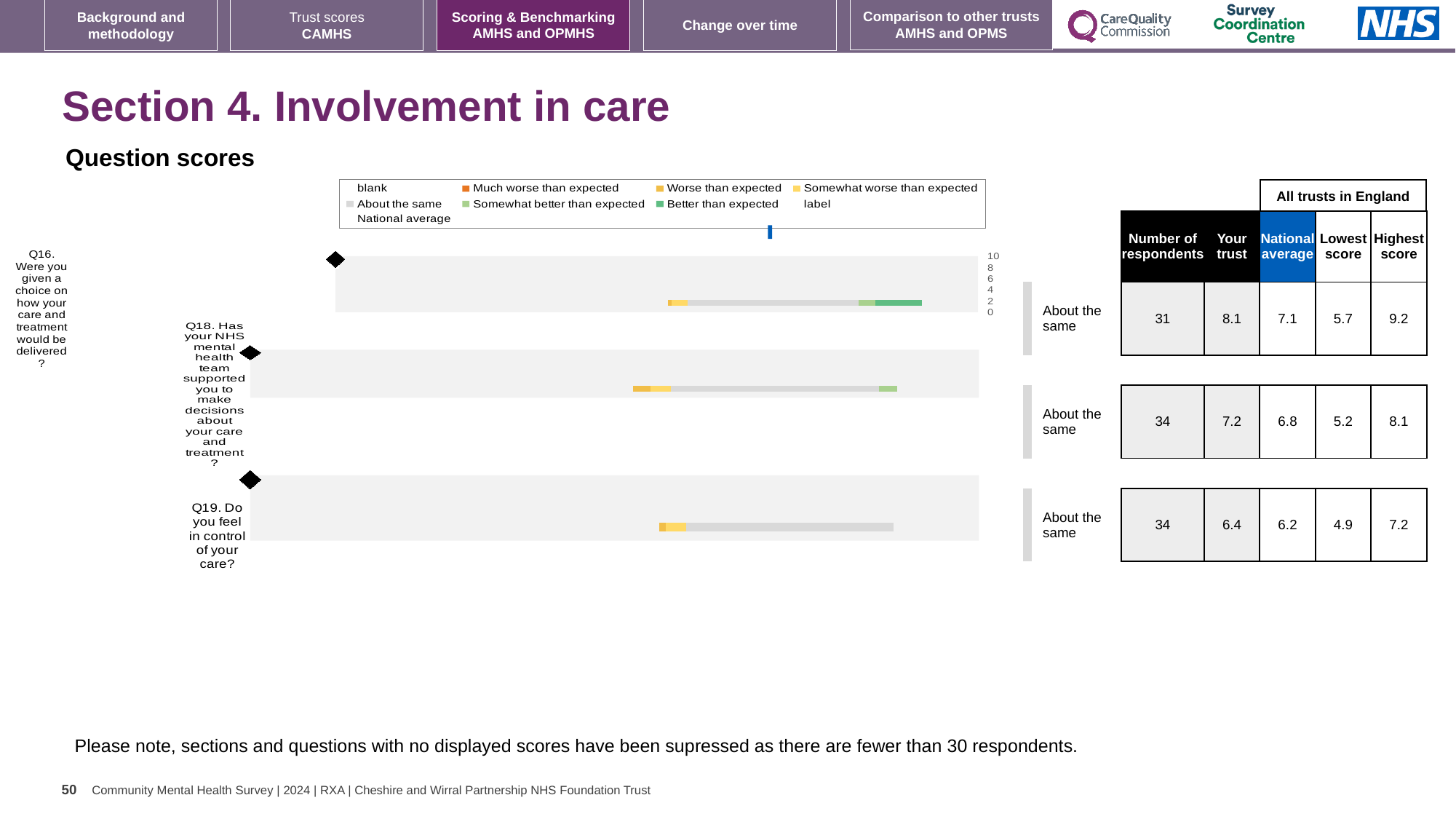
Which question is plotted at the top of the Question scores chart? Q16. Were you given a choice on how your care and treatment would be delivered? In the table beside the chart, what is the national average for Q19 (Do you feel in control of your care?)? 6.2 In the table beside the chart, how many respondents answered Q18? 34 Which question has the lowest 'Your trust' score in the table beside the chart? Q19 How many questions (categories) are plotted in the Question scores chart? 3 What is the difference between the 'Your trust' score and the national average for Q16 in the table beside the chart? 1.0 What kind of chart is shown under 'Question scores'? bar chart For Q18, is the 'Your trust' score or the national average larger in the table beside the chart? Your trust Which question has the highest 'Your trust' score in the table beside the chart? Q16 In the legend of the Question scores chart, what colour represents 'Much worse than expected'? orange In the table beside the chart, what is the highest score across all trusts in England for Q16? 9.2 In the table beside the chart, what is the 'Your trust' score for Q16? 8.1